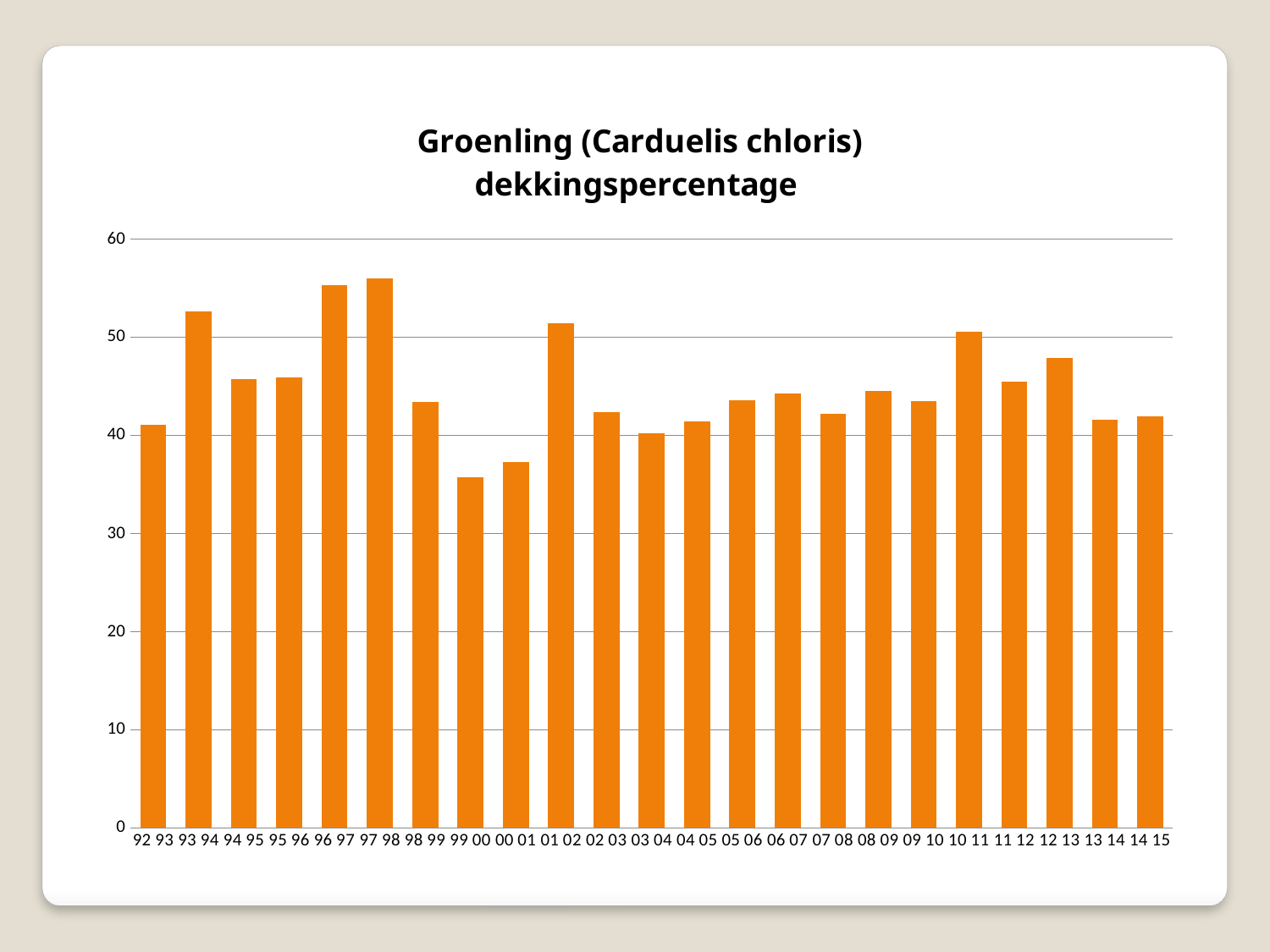
Is the value for 01 02 greater or less than 50? greater Is the value for 12 13 greater or less than 50? less What is the title of the chart? Groenling (Carduelis chloris) dekkingspercentage How many bars (seasons) are plotted in the chart? 23 Is the value for 99 00 greater or less than 40? less Which is larger, the value for 93 94 or the value for 94 95? 93 94 Which season has the lowest dekkingspercentage? 99 00 What kind of chart is shown on the slide? bar chart Which season has the highest dekkingspercentage? 97 98 Which is larger, the value for 11 12 or the value for 12 13? 12 13 Do the values rise or fall from 97 98 to 99 00? fall